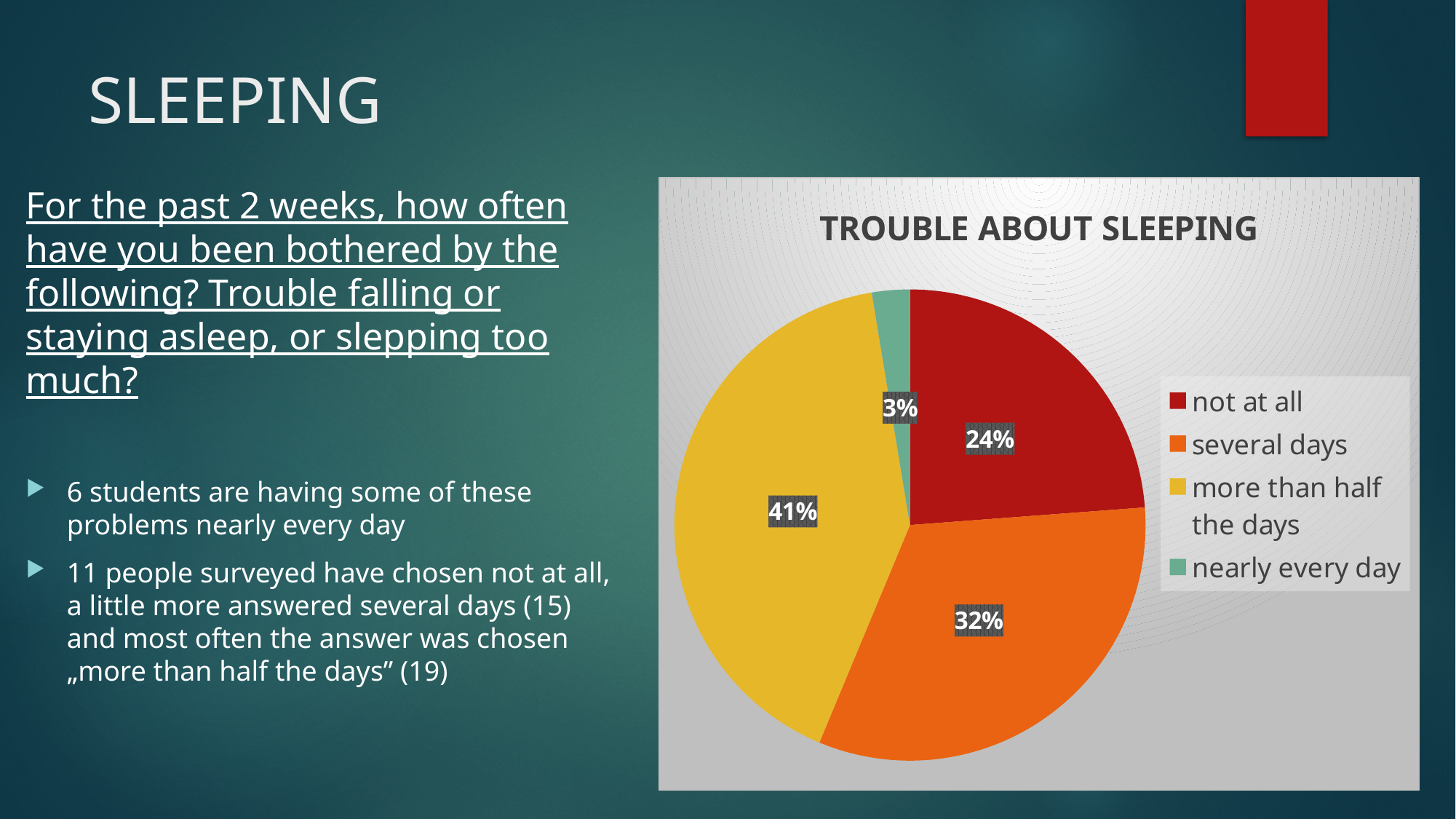
What is the title of the chart? TROUBLE ABOUT SLEEPING Which is larger, the share for "several days" or the share for "not at all"? several days What percentage of the pie is labelled "not at all"? 24% What percentage of the pie is labelled "nearly every day"? 3% What colour is the slice for "nearly every day"? green Which category has the smallest share of the pie? nearly every day What percentage of the pie is labelled "several days"? 32% What is the difference in percentage points between "more than half the days" and "not at all"? 17 How many categories does the legend list? 4 What kind of chart is shown on the slide? pie chart What percentage of the pie is labelled "more than half the days"? 41% Which category has the largest share of the pie? more than half the days